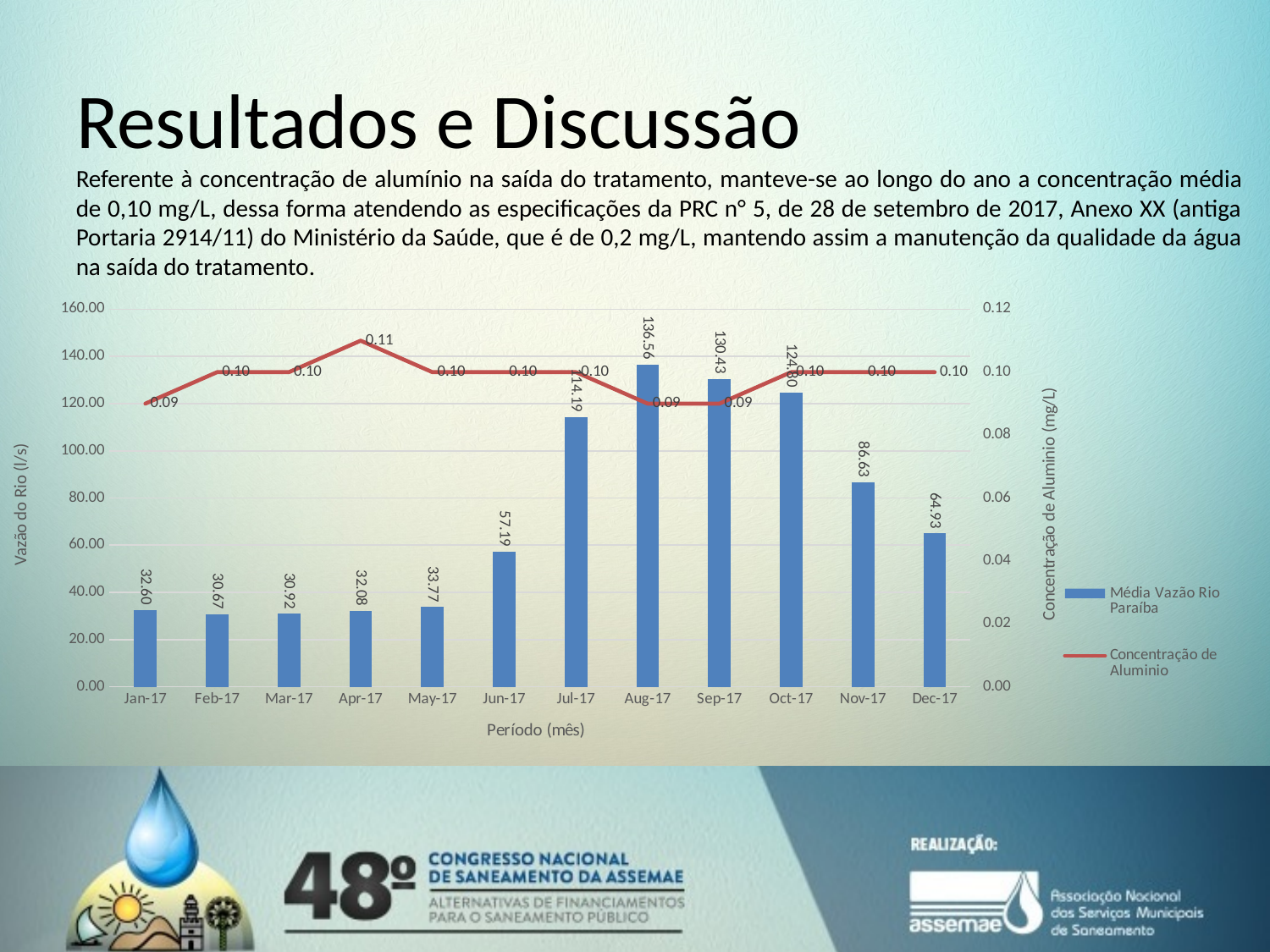
What is the Concentração de Aluminio value for Apr-17? 0.11 Which is larger, the Média Vazão Rio Paraíba for Nov-17 or for Dec-17? Nov-17 What is the label of the left vertical axis? Vazão do Rio (l/s) Which month has the lowest Média Vazão Rio Paraíba? Feb-17 What is the Média Vazão Rio Paraíba value for Jun-17? 57.19 How many series does the legend list? 2 What is the difference between the Média Vazão Rio Paraíba values for Aug-17 and Sep-17? 6.13 Which month has the highest Média Vazão Rio Paraíba? Aug-17 Which month has the highest Concentração de Aluminio? Apr-17 What kind of chart is shown on the slide? Combined bar and line chart How many months are shown on the x axis? 12 What is the Média Vazão Rio Paraíba value for Aug-17? 136.56